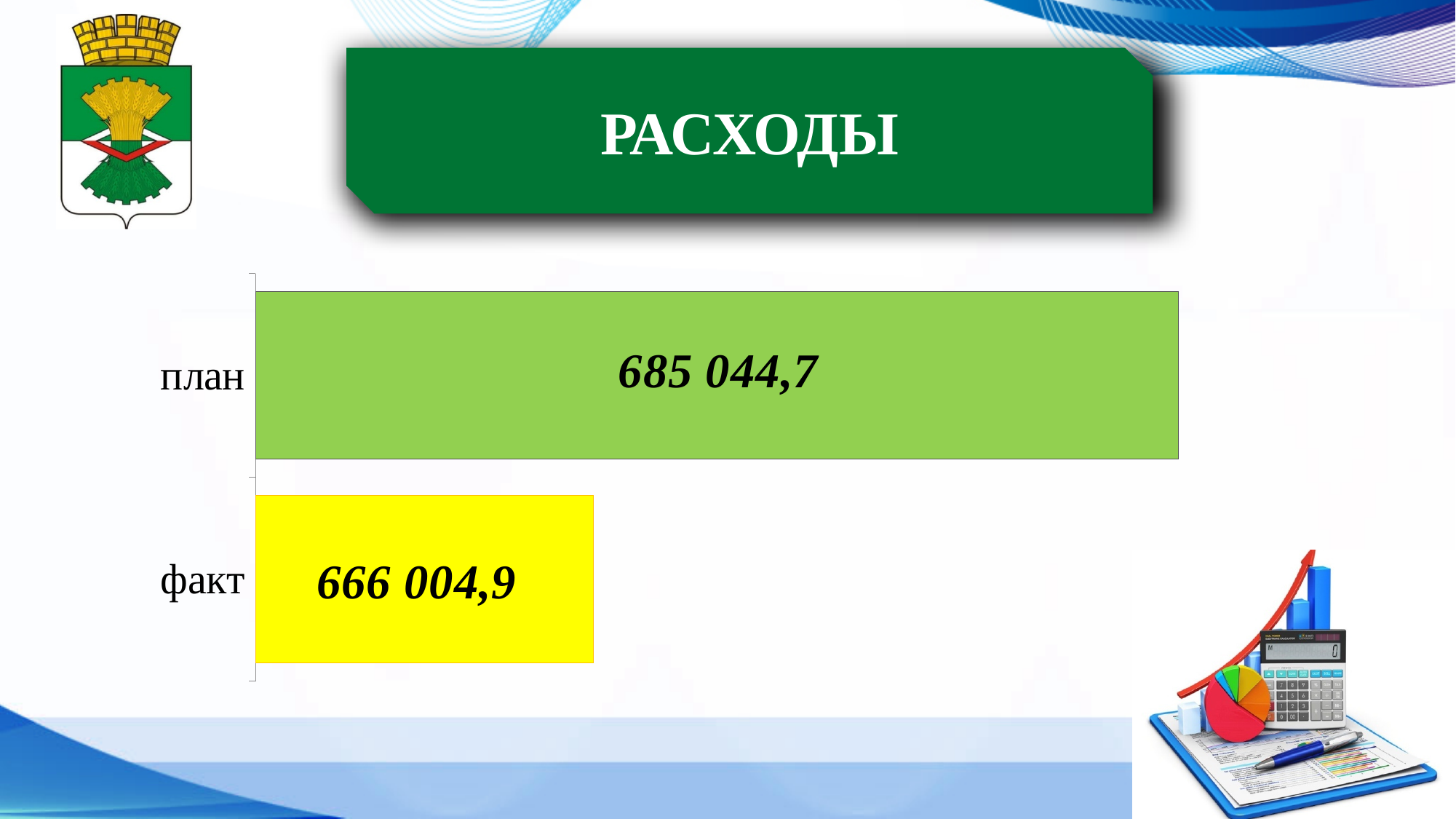
What colour is the bar for факт? yellow What is the value for факт? 666 004,9 How many categories are shown in the chart? 2 What is the difference between the план value and the факт value? 19 039,8 Which category has the higher value, план or факт? план Which category has the highest value? план What is the title shown above the chart? РАСХОДЫ What kind of chart is shown on the slide? bar chart Which category has the lowest value? факт What is the value for план? 685 044,7